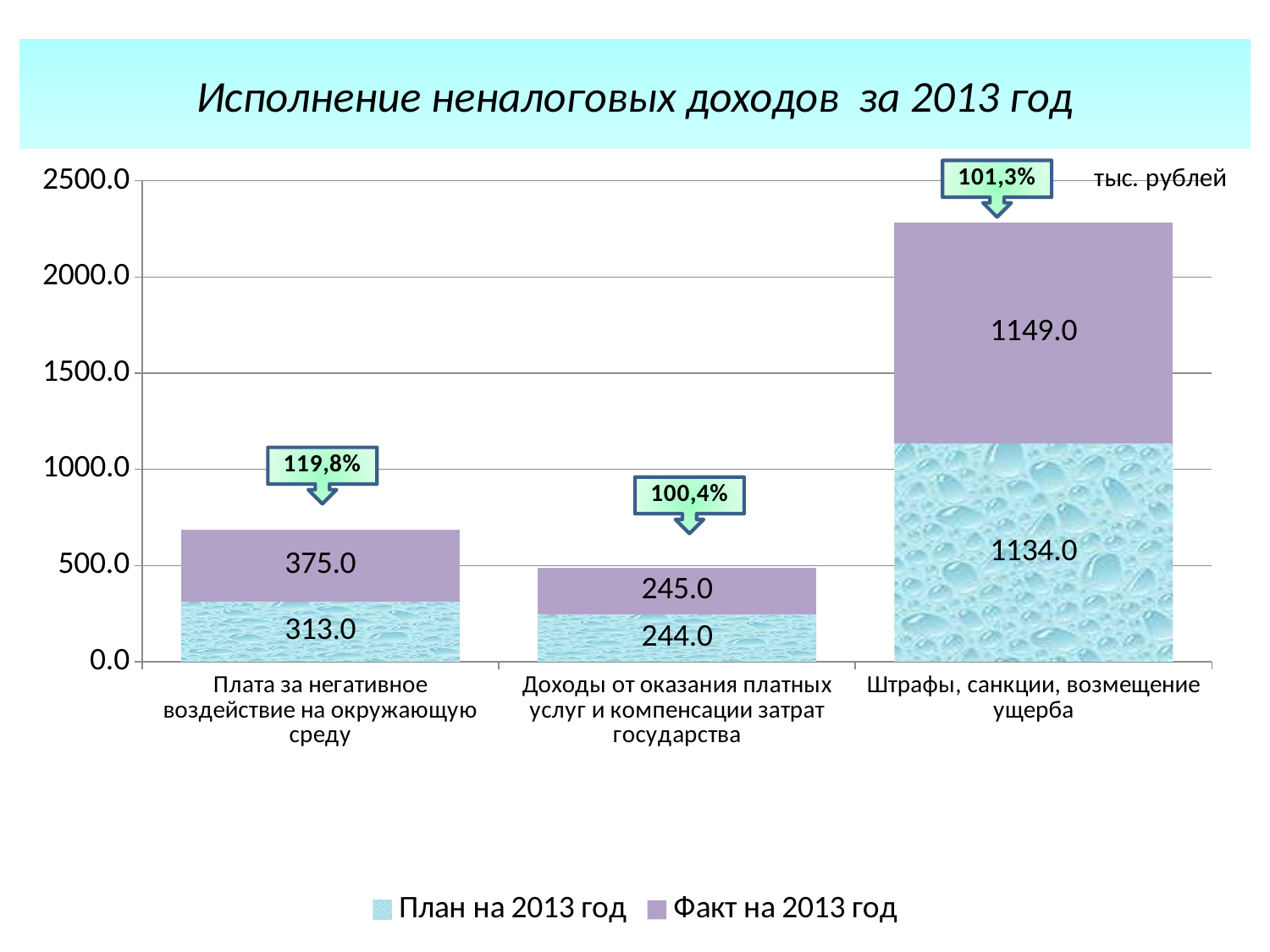
Which category has the lowest 'План на 2013 год' value? Доходы от оказания платных услуг и компенсации затрат государства Which category has the highest 'Факт на 2013 год' value? Штрафы, санкции, возмещение ущерба How many series does the legend list? 2 What percentage is shown in the callout above the 'Штрафы, санкции, возмещение ущерба' bar? 101,3% What is the 'План на 2013 год' value for 'Штрафы, санкции, возмещение ущерба'? 1134.0 How many categories are shown on the x axis? 3 What is the 'План на 2013 год' value for 'Доходы от оказания платных услуг и компенсации затрат государства'? 244.0 Which is larger: the 'Факт на 2013 год' value for 'Плата за негативное воздействие на окружающую среду' or for 'Доходы от оказания платных услуг и компенсации затрат государства'? Плата за негативное воздействие на окружающую среду What is the 'Факт на 2013 год' value for 'Плата за негативное воздействие на окружающую среду'? 375.0 What is the difference between the 'Факт на 2013 год' and 'План на 2013 год' values for 'Плата за негативное воздействие на окружающую среду'? 62.0 What is the total of the stacked bar for 'Штрафы, санкции, возмещение ущерба'? 2283.0 What kind of chart is shown on the slide? Stacked bar chart